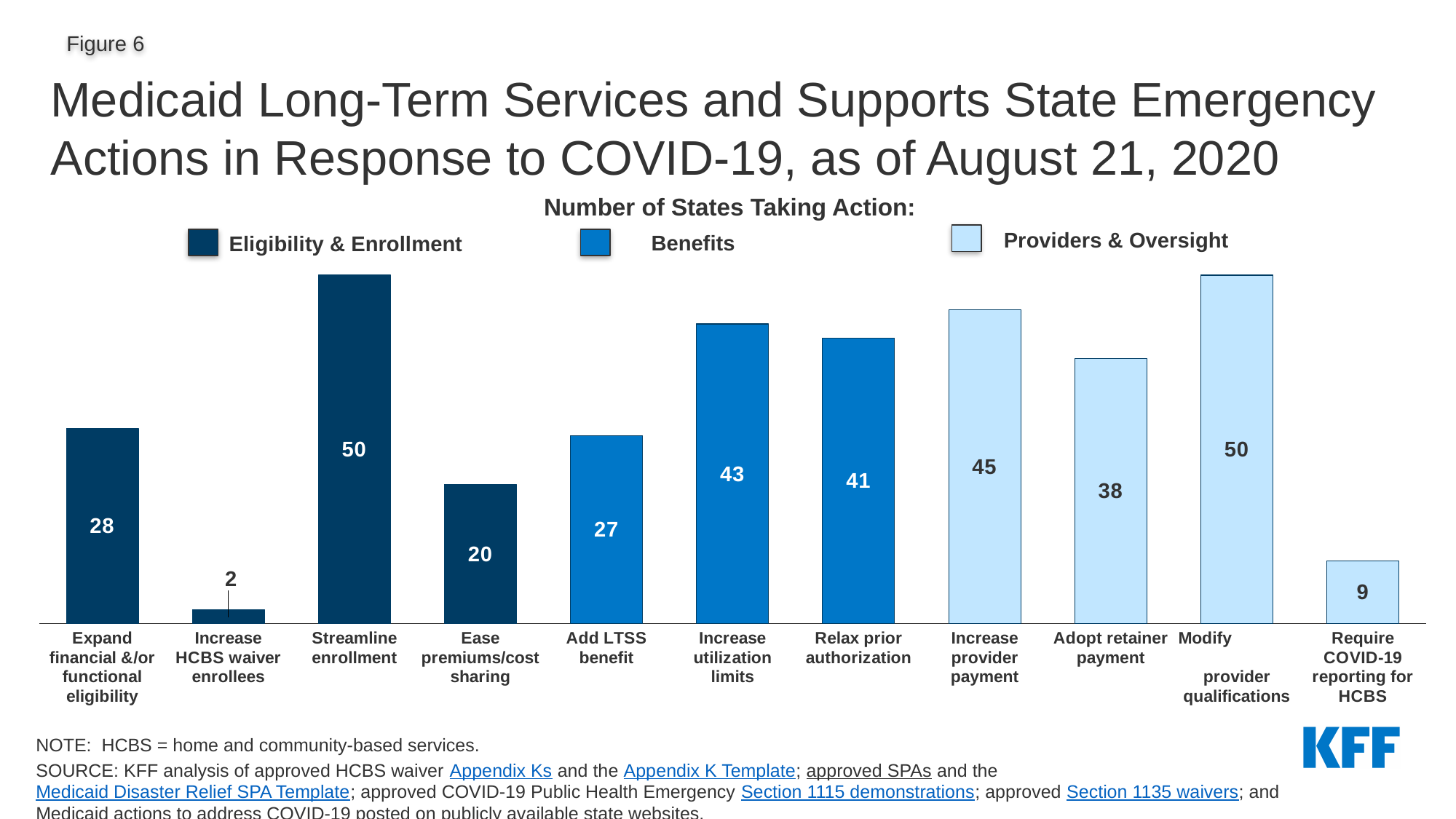
How many states took action to streamline enrollment? 50 What kind of chart is shown on the slide? Bar chart What is the number of states that relaxed prior authorization? 41 Which action was taken by the fewest states? Increase HCBS waiver enrollees Which legend category is shown in the lightest blue? Providers & Oversight How many series does the legend list? 3 What is the difference between the number of states that increased utilization limits and the number that added an LTSS benefit? 16 Which action was taken by more states: expanding financial and/or functional eligibility or easing premiums/cost sharing? Expand financial &/or functional eligibility How many states required COVID-19 reporting for HCBS? 9 How many actions (bars) are shown in the chart? 11 How many states adopted retainer payment? 38 What is the difference between the number of states that increased provider payment and the number that adopted retainer payment? 7